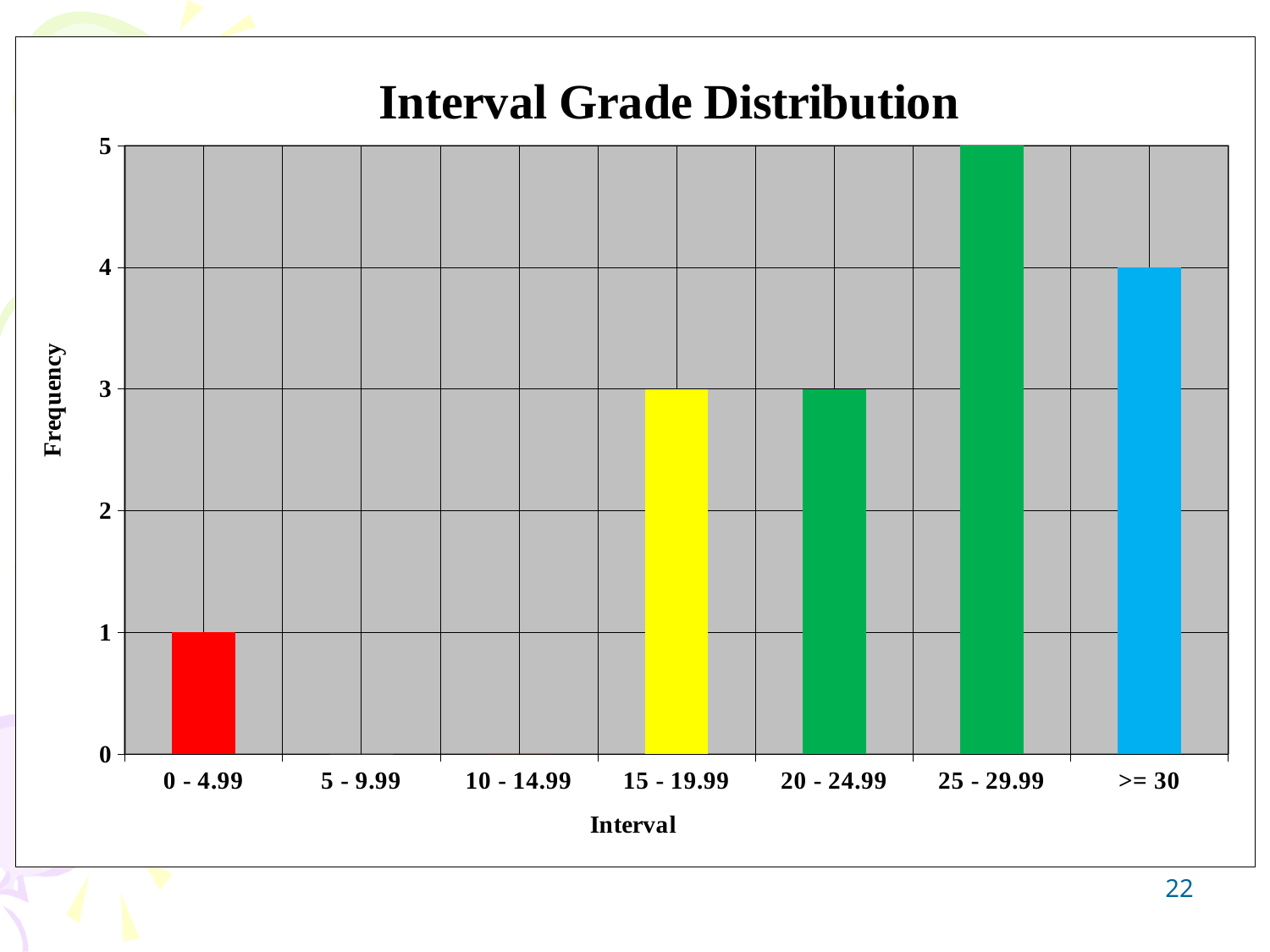
Is the frequency for the >= 30 interval greater or less than 3? greater What is the frequency for the 15 - 19.99 interval? 3 How many intervals are shown on the x axis? 7 What is the frequency for the 25 - 29.99 interval? 5 What is the label of the y axis? Frequency Which has a higher frequency, the 0 - 4.99 interval or the 20 - 24.99 interval? 20 - 24.99 What is the title of the chart? Interval Grade Distribution What is the frequency for the 0 - 4.99 interval? 1 What is the frequency for the >= 30 interval? 4 Which interval has the highest frequency? 25 - 29.99 What kind of chart is shown on the slide? bar chart What is the difference in frequency between the 25 - 29.99 interval and the >= 30 interval? 1